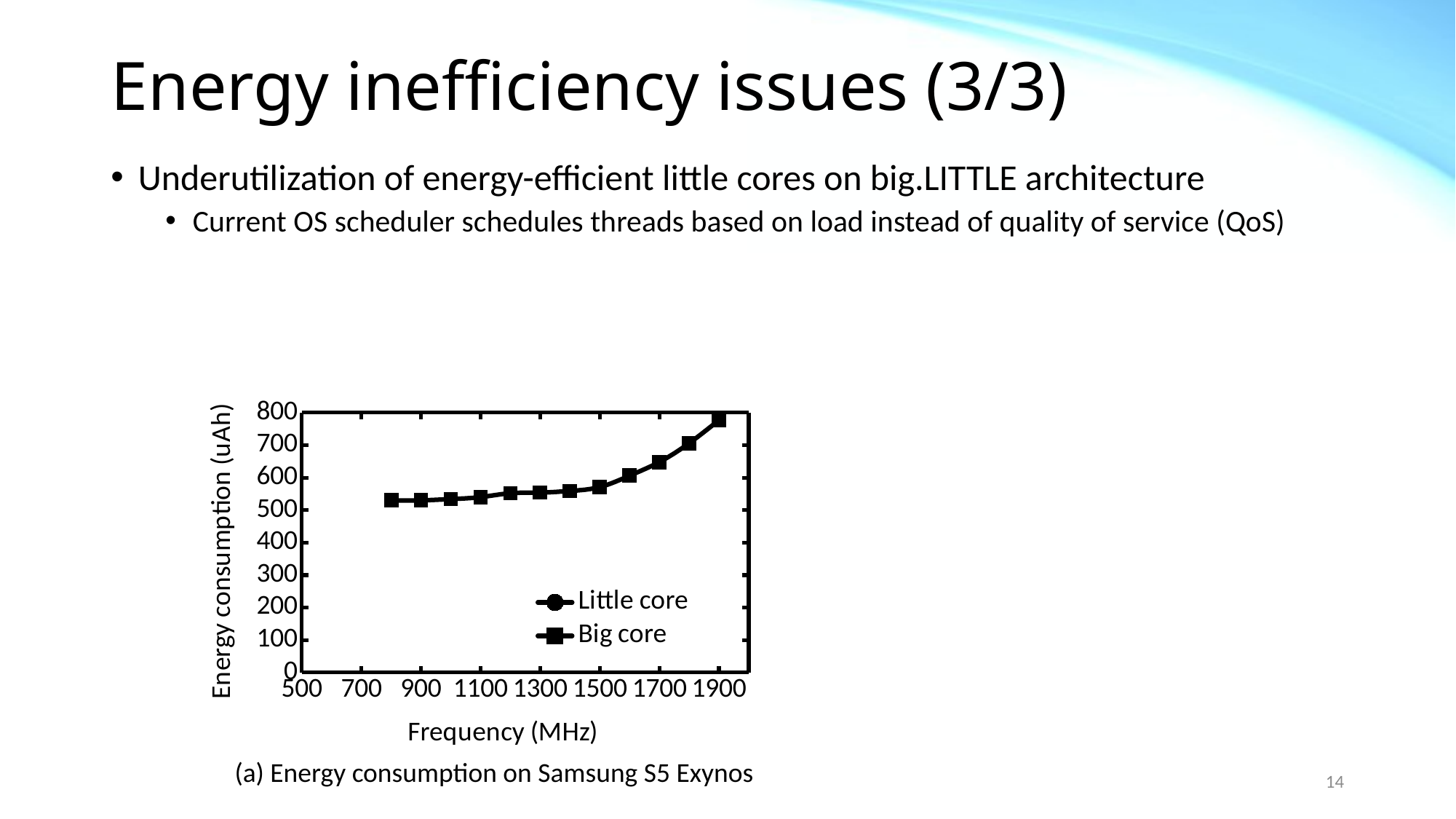
How many data points are plotted for the Big core series? 12 Is the Big core energy consumption at 1700 MHz greater or less than 600? greater How many series does the legend list? 2 Which two series are listed in the legend? Little core and Big core Which is larger for the Big core: energy consumption at 1900 MHz or at 800 MHz? 1900 MHz Is the Big core energy consumption at 1900 MHz greater or less than 700? greater What is the label of the y axis? Energy consumption (uAh) Is the Big core energy consumption at 800 MHz greater or less than 500? greater Does the energy consumption of the Big core rise or fall as frequency increases? rises At which frequency is the Big core energy consumption highest? 1900 MHz What kind of chart is shown on the slide? line chart